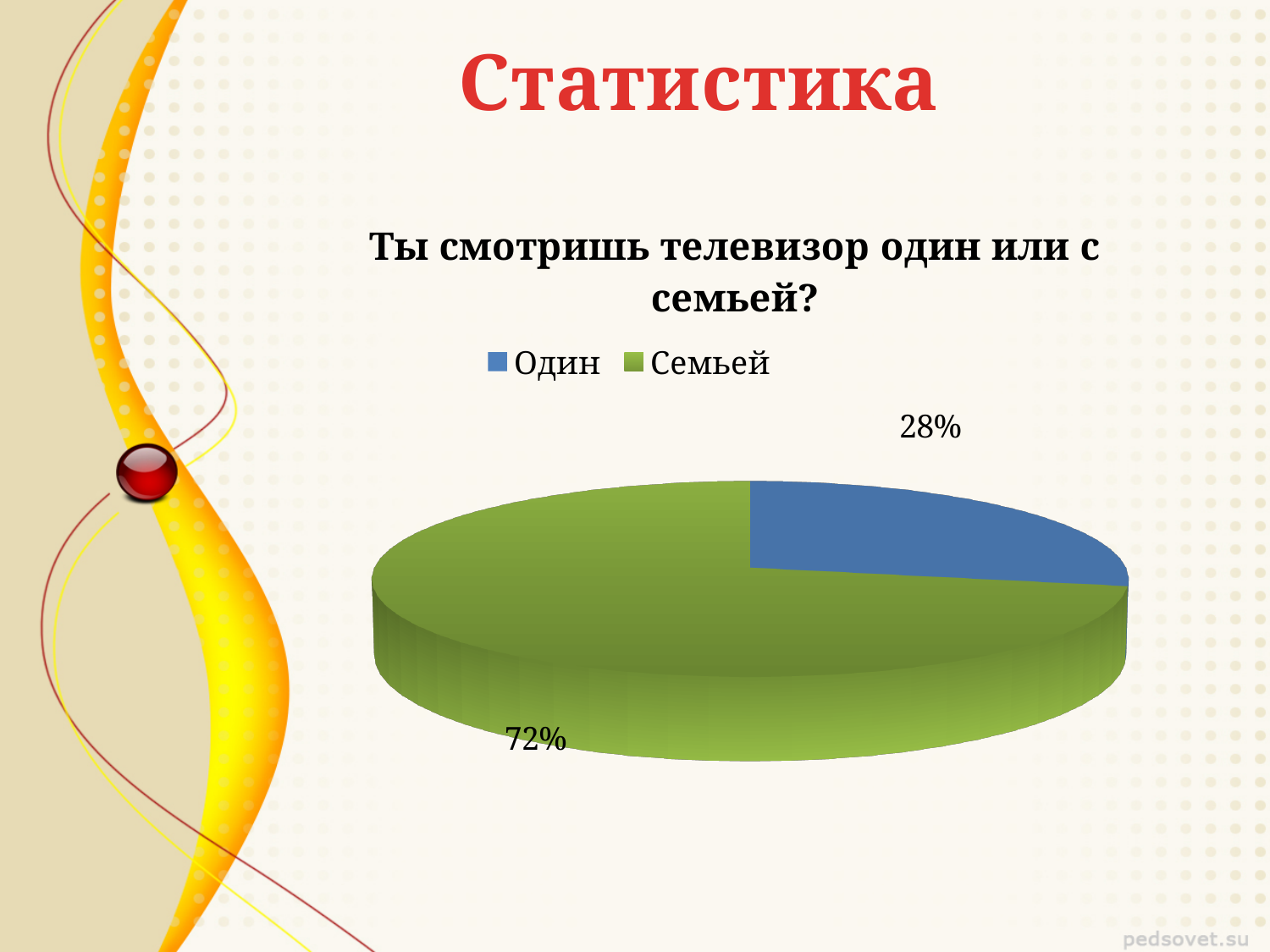
What kind of chart is shown on the slide? pie chart What share of the pie does "Семьей" take? 72% What is the difference in percentage points between "Семьей" and "Один"? 44 How many slices does the pie chart have? 2 What share of the pie does "Один" take? 28% What colour is the slice for "Один"? blue Which category has the smallest slice? Один Which is larger, the slice for "Один" or the slice for "Семьей"? Семьей What is the chart's title? Ты смотришь телевизор один или с семьей? How many entries does the legend list? 2 Which category has the largest slice? Семьей